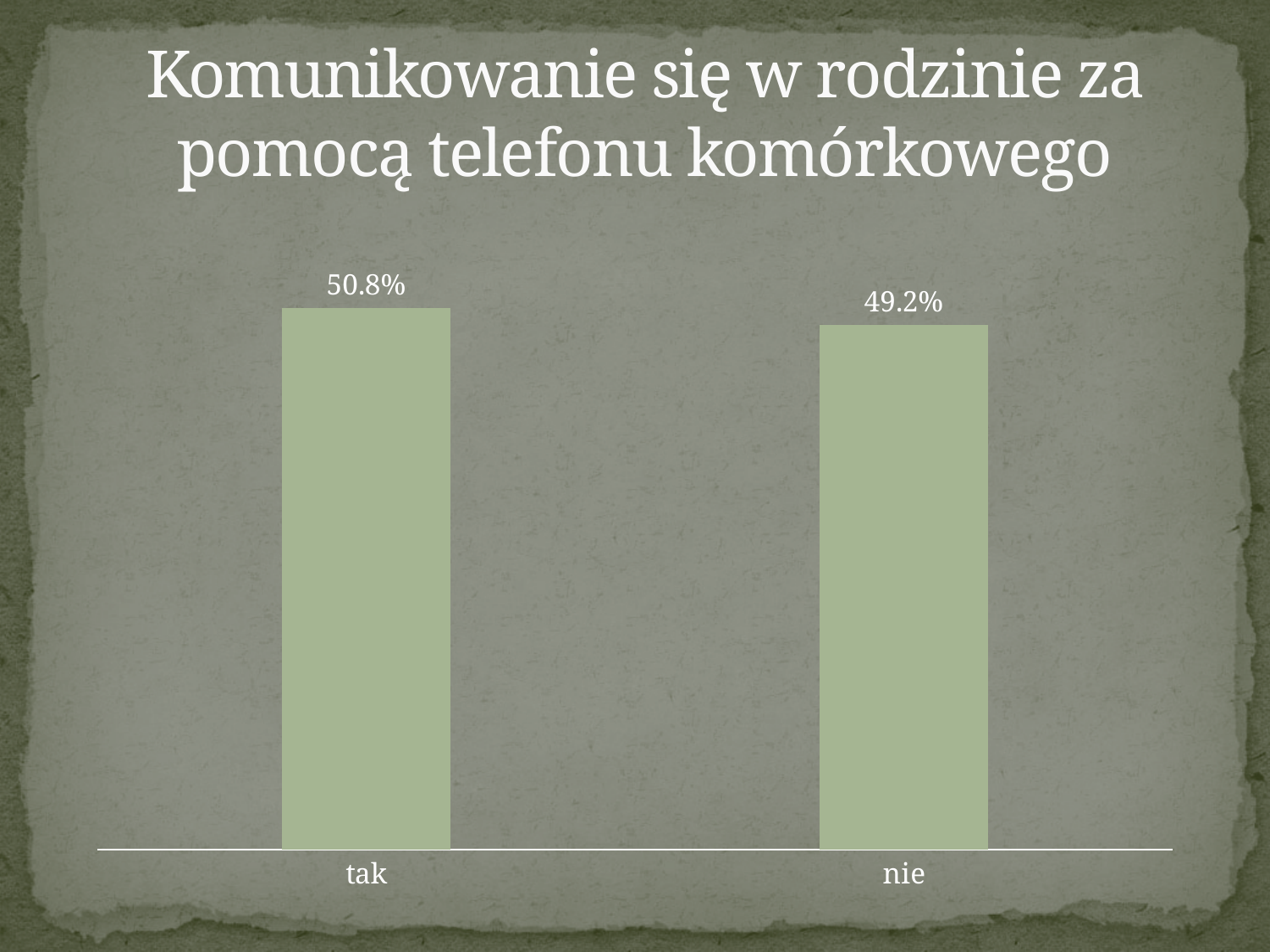
What are the category labels on the x axis? tak, nie How many categories are shown in the chart? 2 What is the title of the slide? Komunikowanie się w rodzinie za pomocą telefonu komórkowego What is the value for "tak"? 50.8% What is the difference between the values for "tak" and "nie"? 1.6% Which category has the lowest value? nie Which category has the highest value? tak Which is larger, the value for "tak" or the value for "nie"? tak What kind of chart is shown on the slide? bar chart What is the value for "nie"? 49.2%